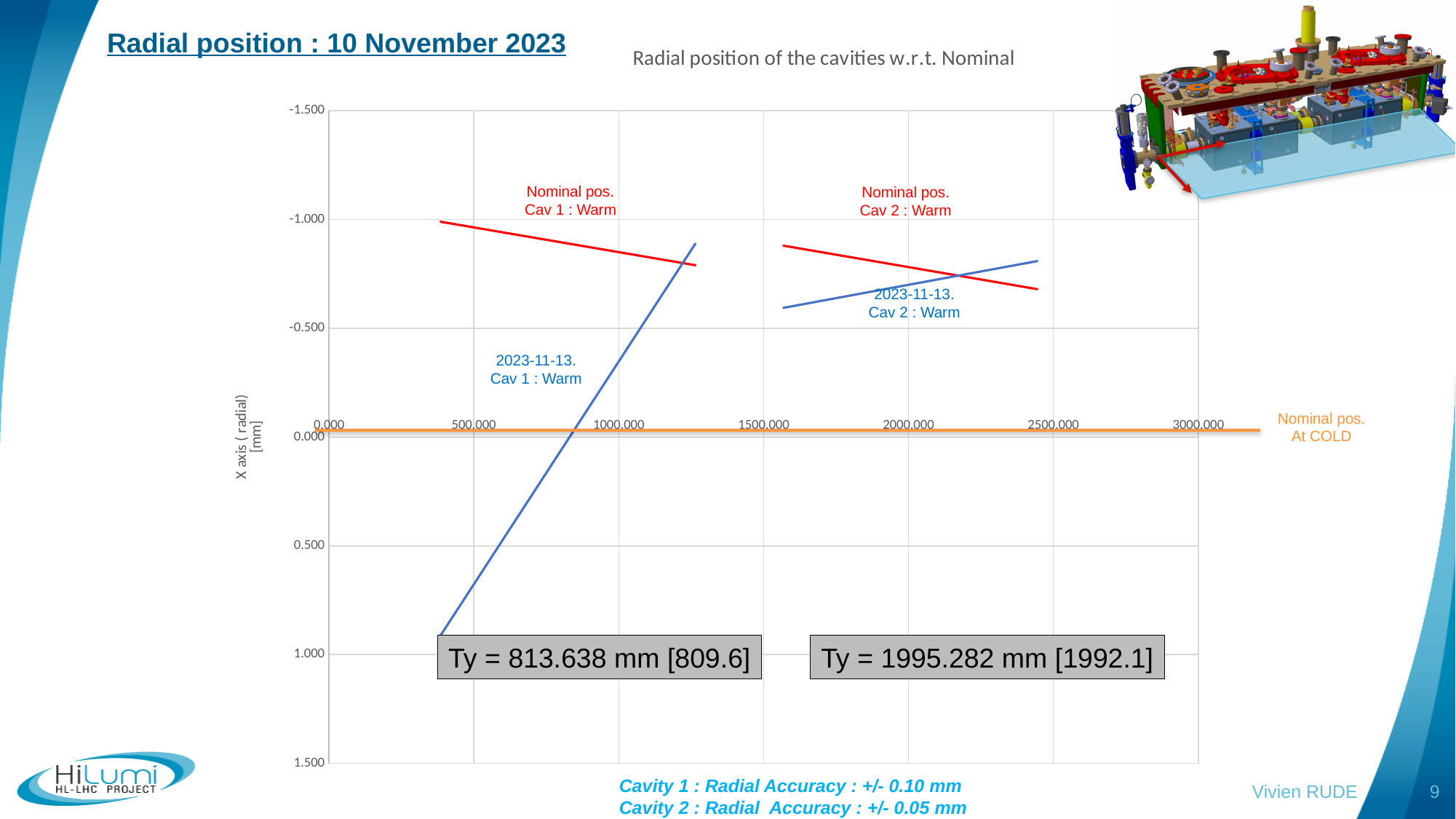
Is the value of the 'Nominal pos. Cav 2 : Warm' line at its left end (near 1500.000) greater or less than -0.500? less What is the radial accuracy stated for Cavity 2? +/- 0.05 mm What Ty value is given in the text box for cavity 1? Ty = 813.638 mm [809.6] How many labelled lines are plotted on the chart? 5 What Ty value is given in the text box for cavity 2? Ty = 1995.282 mm [1992.1] Do the values of the '2023-11-13. Cav 1 : Warm' line numerically rise or fall as the x value increases? fall Is the value of the '2023-11-13. Cav 1 : Warm' line at its left end (near 500.000) greater or less than 0.500? greater What is the label of the vertical axis of the chart? X axis ( radial) [mm] What kind of chart is shown on the slide? line chart What is the title of the chart? Radial position of the cavities w.r.t. Nominal At what radial value does the orange 'Nominal pos. At COLD' line lie? 0.000 Is the value of the 'Nominal pos. Cav 1 : Warm' line at its right end (near 1250.000) greater or less than -0.500? less